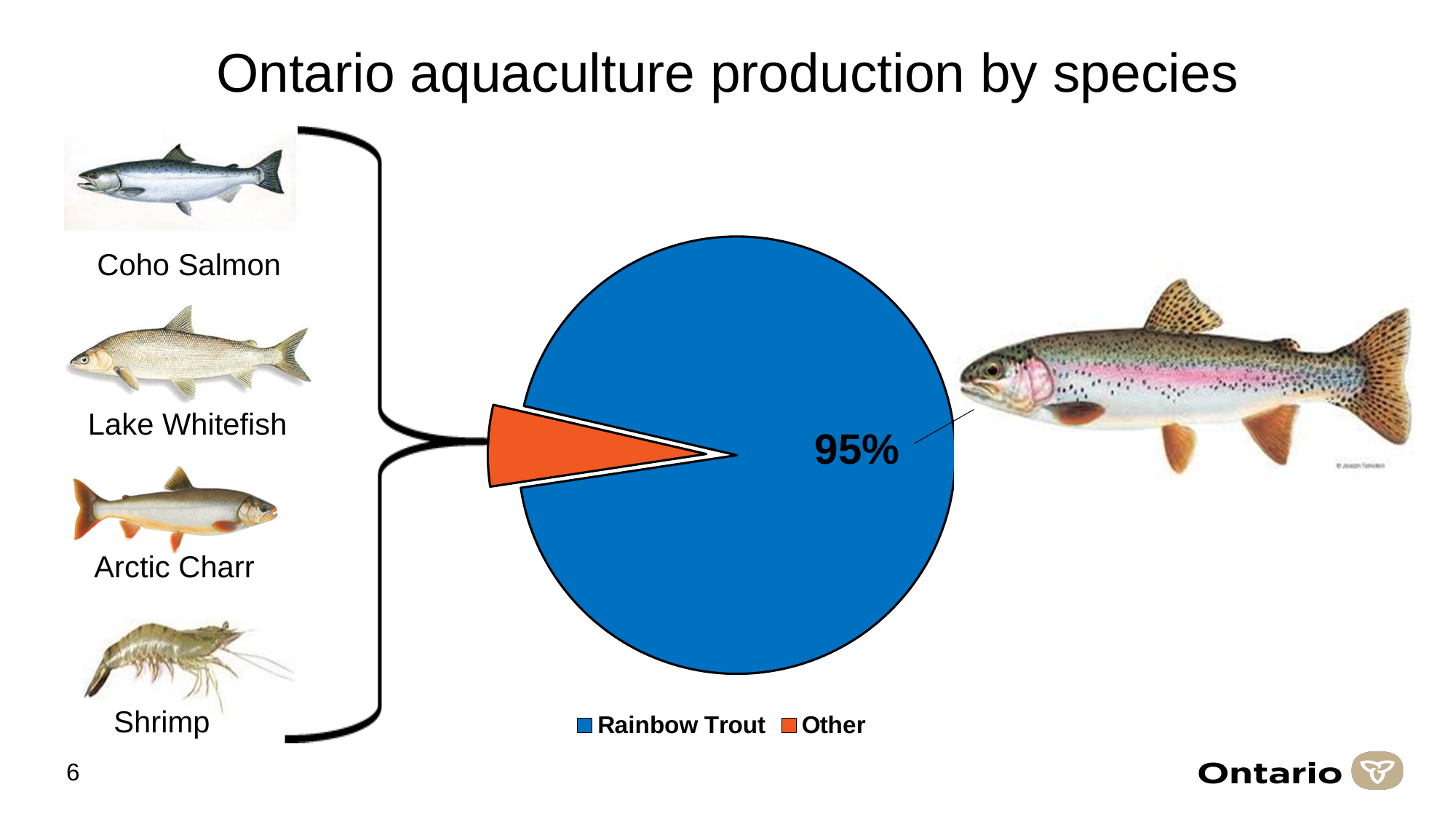
What share of Ontario aquaculture production is Rainbow Trout? 95% What is the value printed on the Rainbow Trout slice? 95% Which slice of the pie chart is the largest? Rainbow Trout What kind of chart is shown on the slide? pie chart Which slice of the pie chart is the smallest? Other How many slices does the pie chart have? 2 Which is larger, the Rainbow Trout slice or the Other slice? Rainbow Trout How many entries does the legend list? 2 What colour is the Other slice in the pie chart? orange What is the title of the slide containing the pie chart? Ontario aquaculture production by species